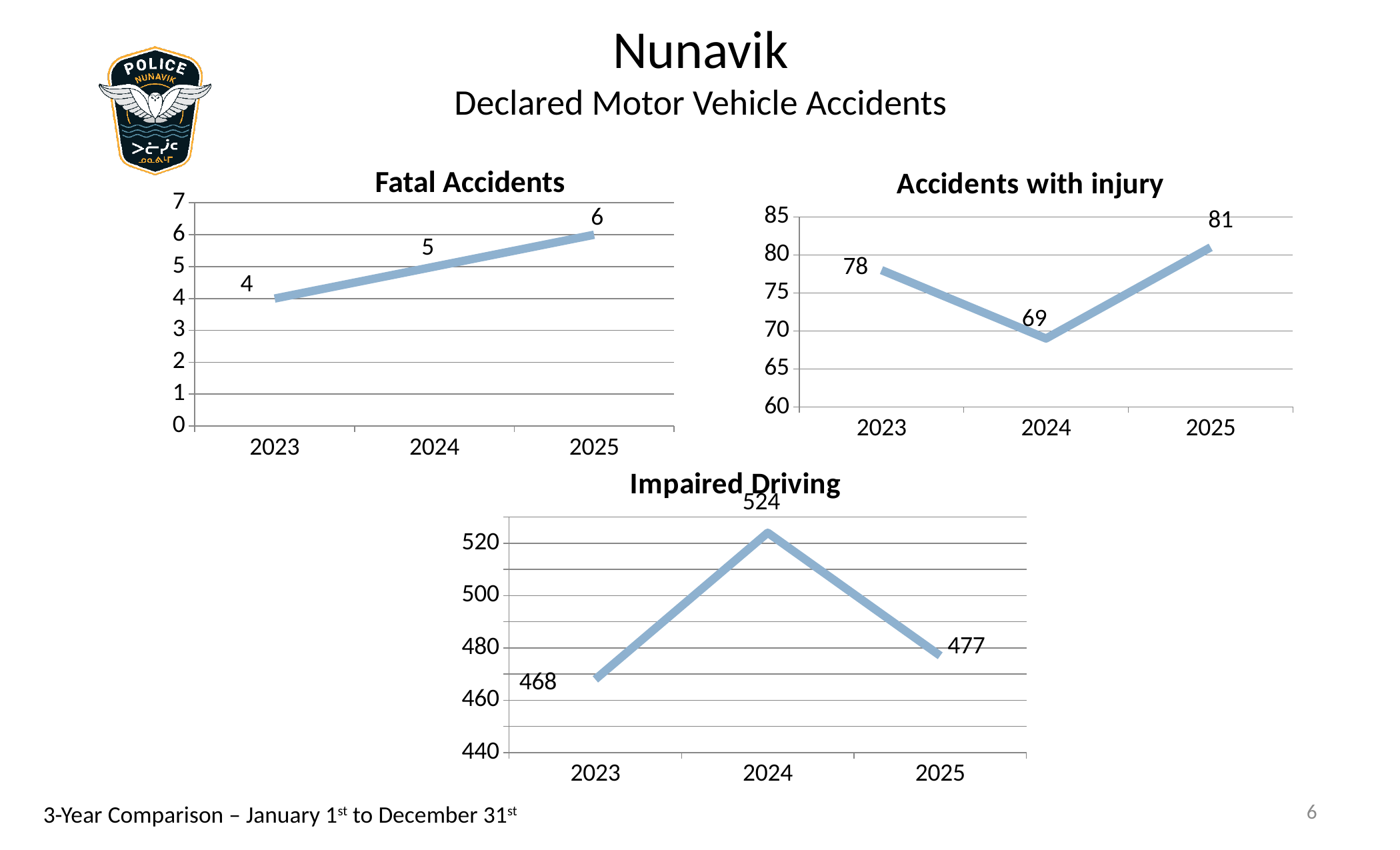
In the Fatal Accidents chart, what is the value for 2025? 6 In the Accidents with injury chart, what is the value for 2024? 69 In the Impaired Driving chart, how many years are plotted? 3 In the Fatal Accidents chart, what is the difference between the 2025 and 2023 values? 2 In the Impaired Driving chart, which is larger, the value for 2023 or the value for 2025? 2025 In the Impaired Driving chart, which year has the highest value? 2024 In the Accidents with injury chart, which year has the lowest value? 2024 What kind of chart is the Fatal Accidents chart? line chart In the Accidents with injury chart, which year has the highest value? 2025 In the Impaired Driving chart, what is the value for 2023? 468 In the Fatal Accidents chart, do the values rise or fall from 2023 to 2025? rise In the Accidents with injury chart, what is the difference between the 2023 and 2024 values? 9